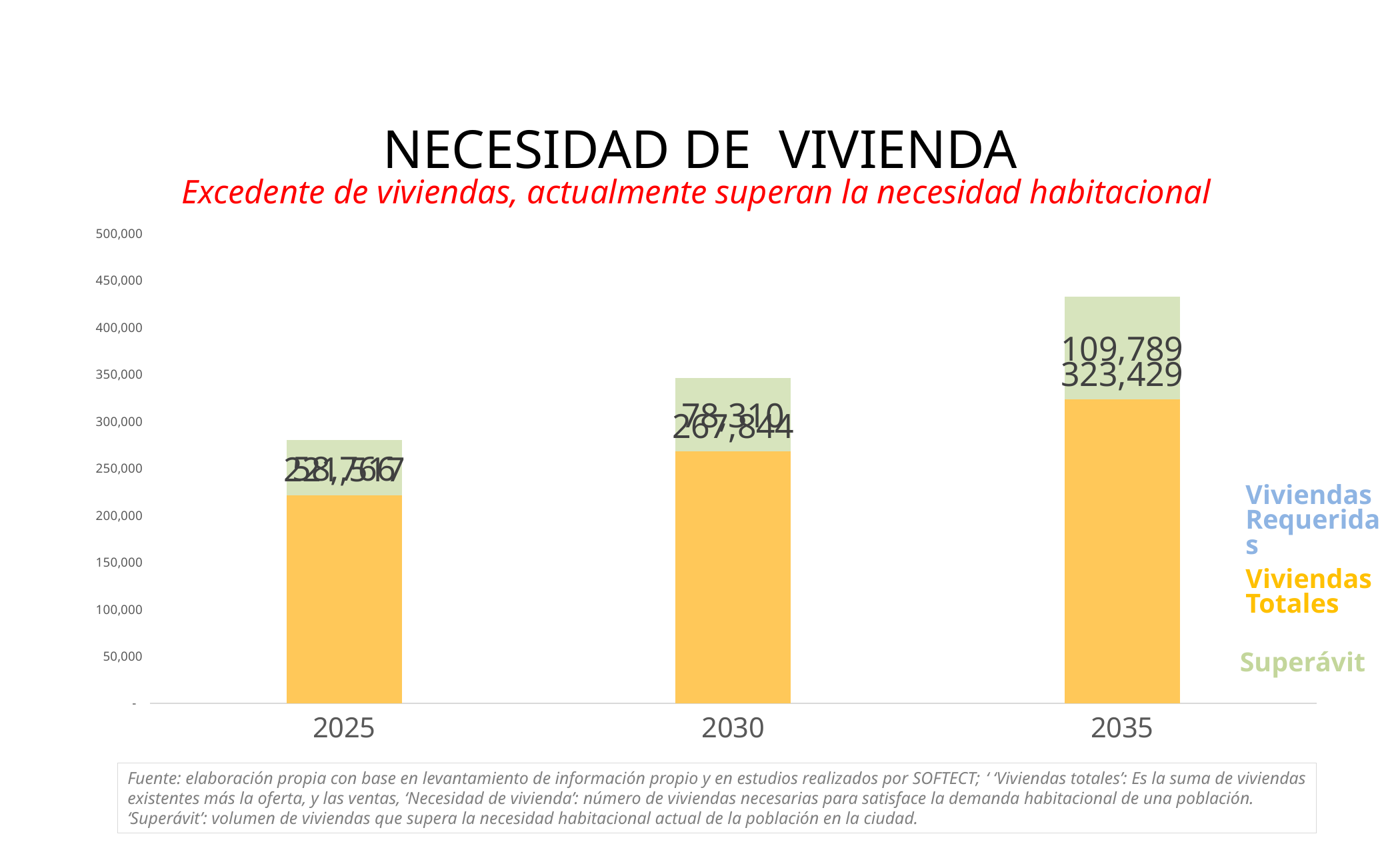
Do the stacked bar totals rise or fall from 2025 to 2035? rise Is the Viviendas Totales value for 2025 greater or less than 250,000? less What is the value of Superávit for 2035? 109,789 How many series does the chart legend list? 3 Which year has the highest Viviendas Totales value? 2035 What kind of chart is shown on the slide? Stacked bar chart How many years are shown on the x axis of the chart? 3 What is the value of Viviendas Totales for 2035? 323,429 What is the value of Viviendas Totales for 2030? 267,844 What is the value of Superávit for 2030? 78,310 By how much does Viviendas Totales in 2035 exceed Viviendas Totales in 2030? 55,585 What is the total height of the stacked bar for 2035 (Viviendas Totales plus Superávit)? 433,218